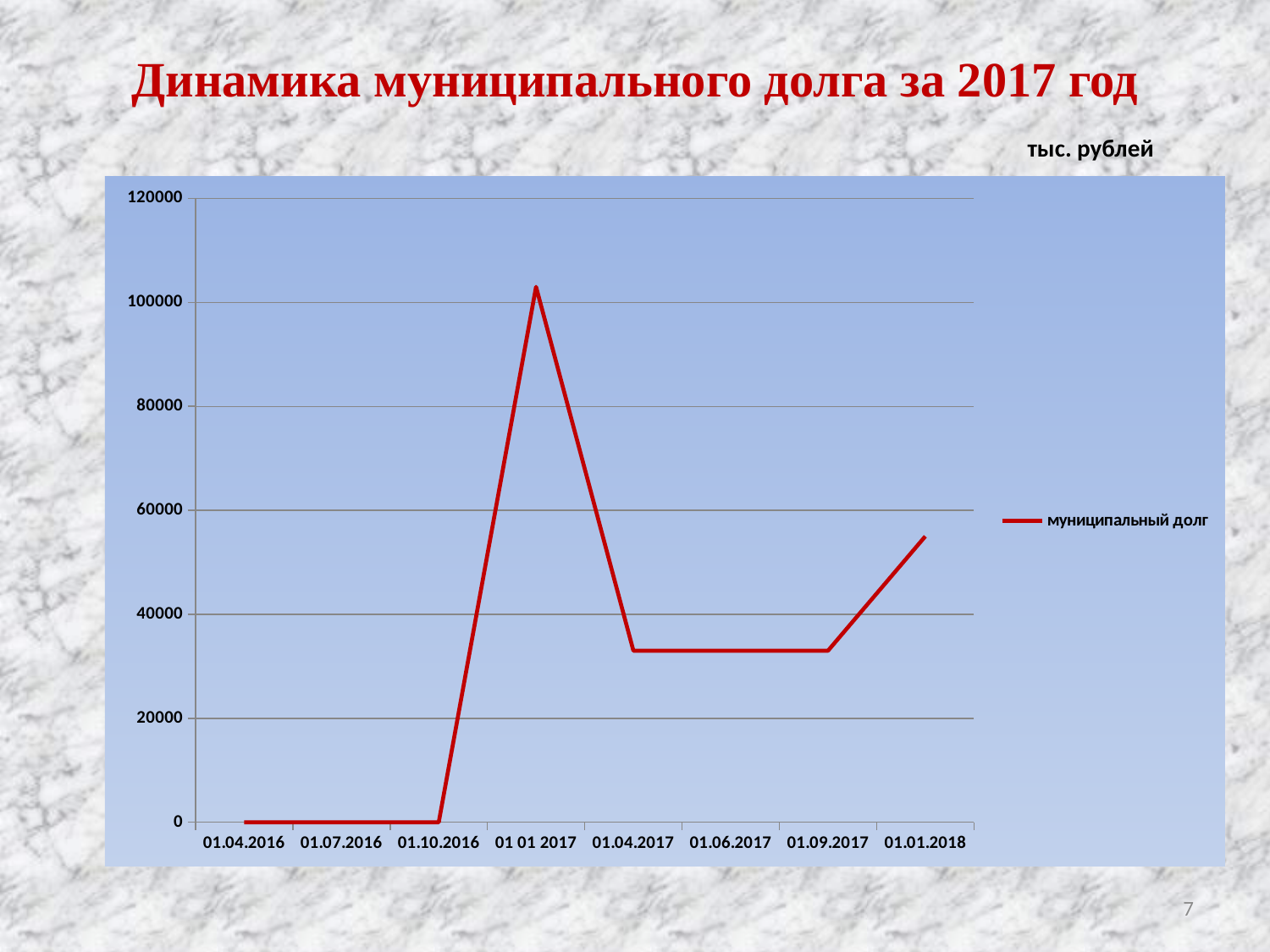
How many series does the legend list? 1 What kind of chart is shown on the slide? line chart What is the value of the municipal debt on 01.10.2016? 0 Which is larger, the value on 01 01 2017 or the value on 01.01.2018? 01 01 2017 Is the value for 01.04.2017 greater or less than 40000? less Is the value for 01 01 2017 greater or less than 100000? greater On which date does the municipal debt reach its highest value? 01 01 2017 How many dates are shown on the x axis? 8 What is the title of the chart on the slide? Динамика муниципального долга за 2017 год What is the value of the municipal debt on 01.04.2016? 0 Is the value for 01.01.2018 greater or less than 40000? greater What is the name of the series shown in the legend? муниципальный долг